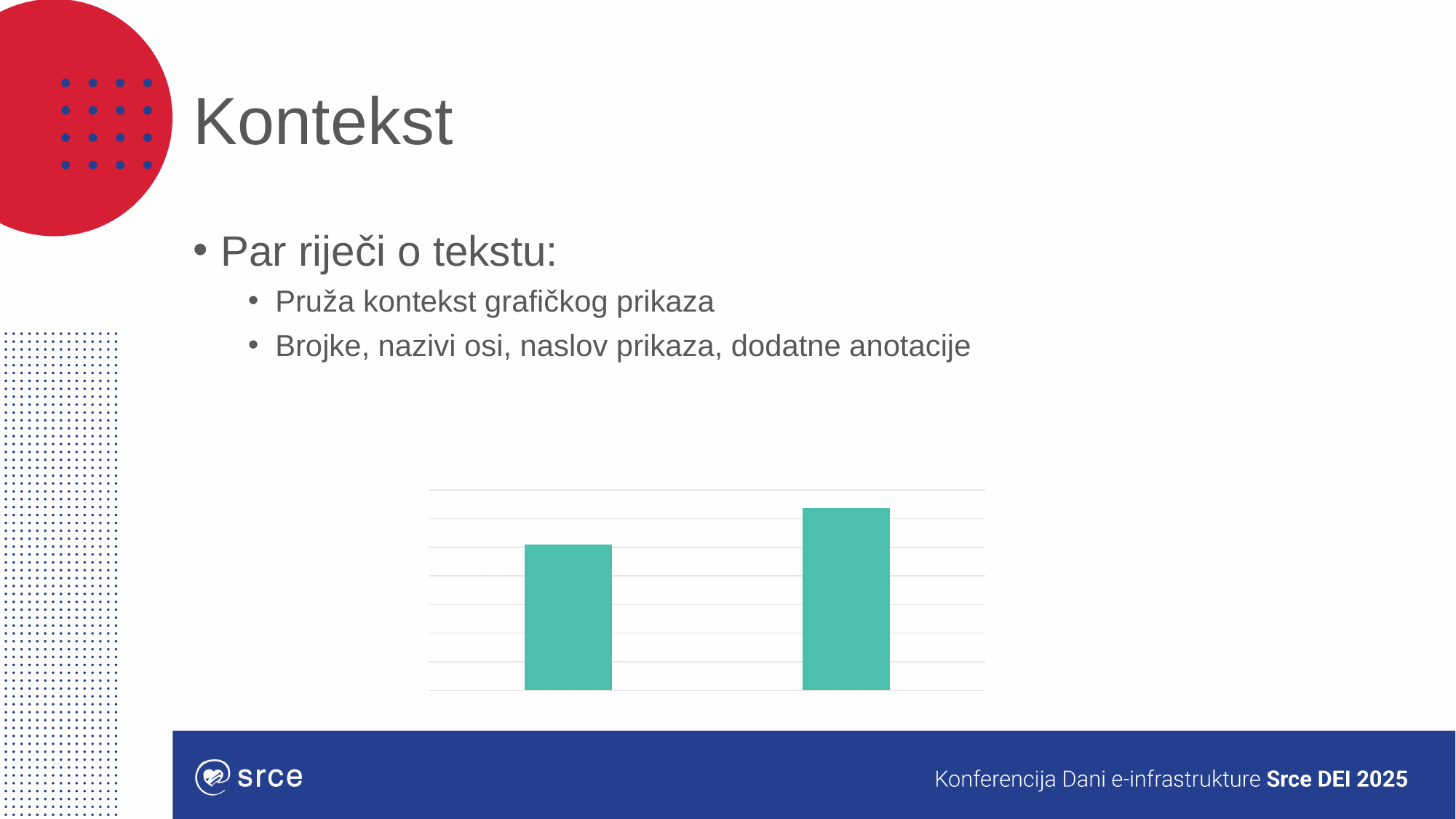
How many bars does the chart on the slide show? 2 Does the chart on the slide display any axis labels or data labels? No Which bar in the chart is the shortest, the left one or the right one? the left one Do the bar heights rise or fall from left to right in the chart? rise What colour are the bars in the chart? teal Which bar in the chart is taller, the left one or the right one? the right one What kind of chart is shown on the slide? bar chart